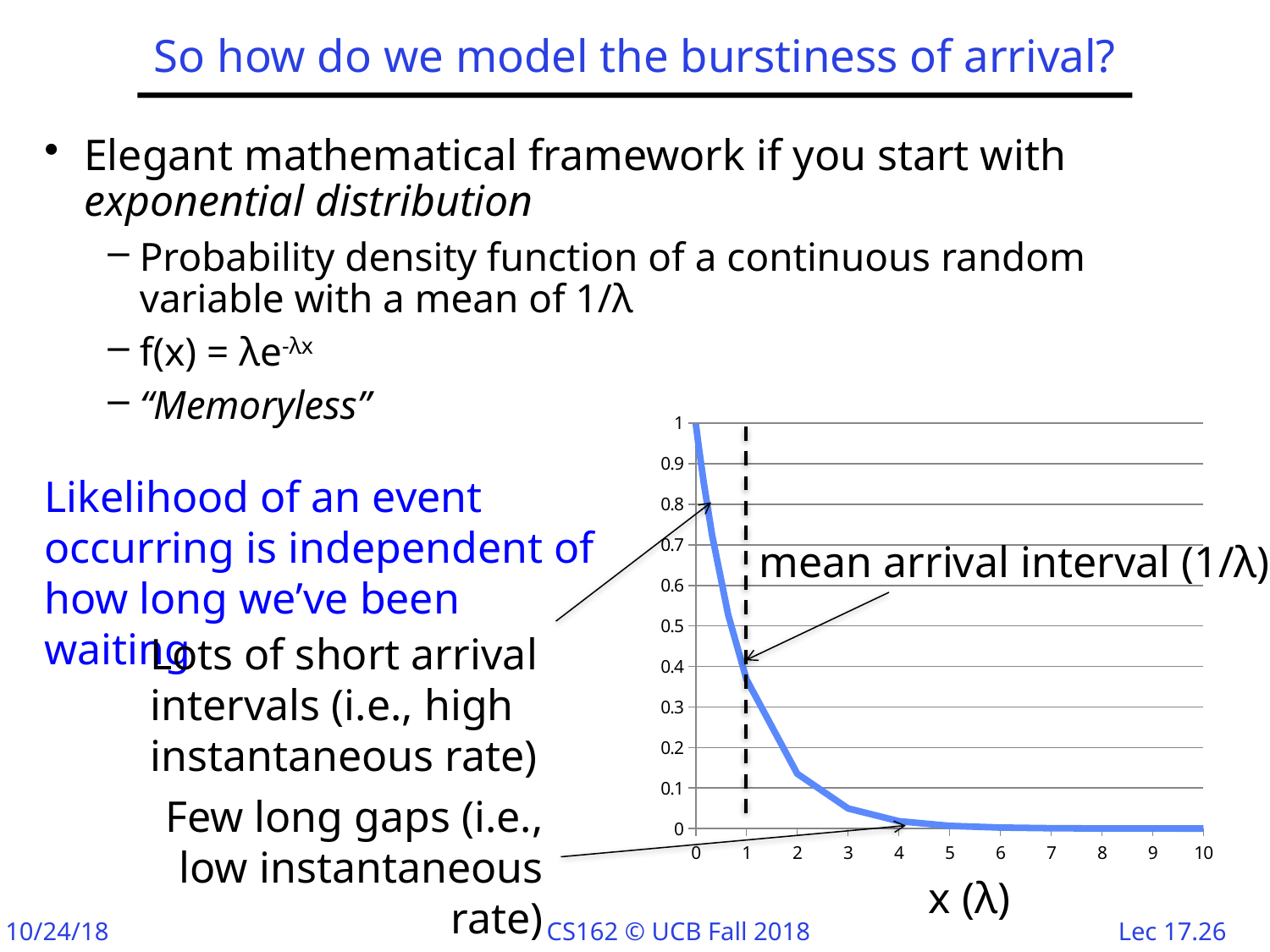
Is the value of the curve at x = 4 greater or less than 0.1? less Is the value of the curve at x = 2 greater or less than 0.3? less At what x value is the dashed vertical line drawn? 1 Do the plotted values rise or fall as x increases along the x axis? fall What kind of chart is shown on the slide? line chart What is the label of the x axis of the chart? x (λ) What is the largest value shown on the x axis? 10 Is the value of the curve at x = 0.5 greater or less than 0.5? greater Which is larger, the value of the curve at x = 1 or at x = 3? x = 1 What does the dashed vertical line on the chart mark? mean arrival interval (1/λ)